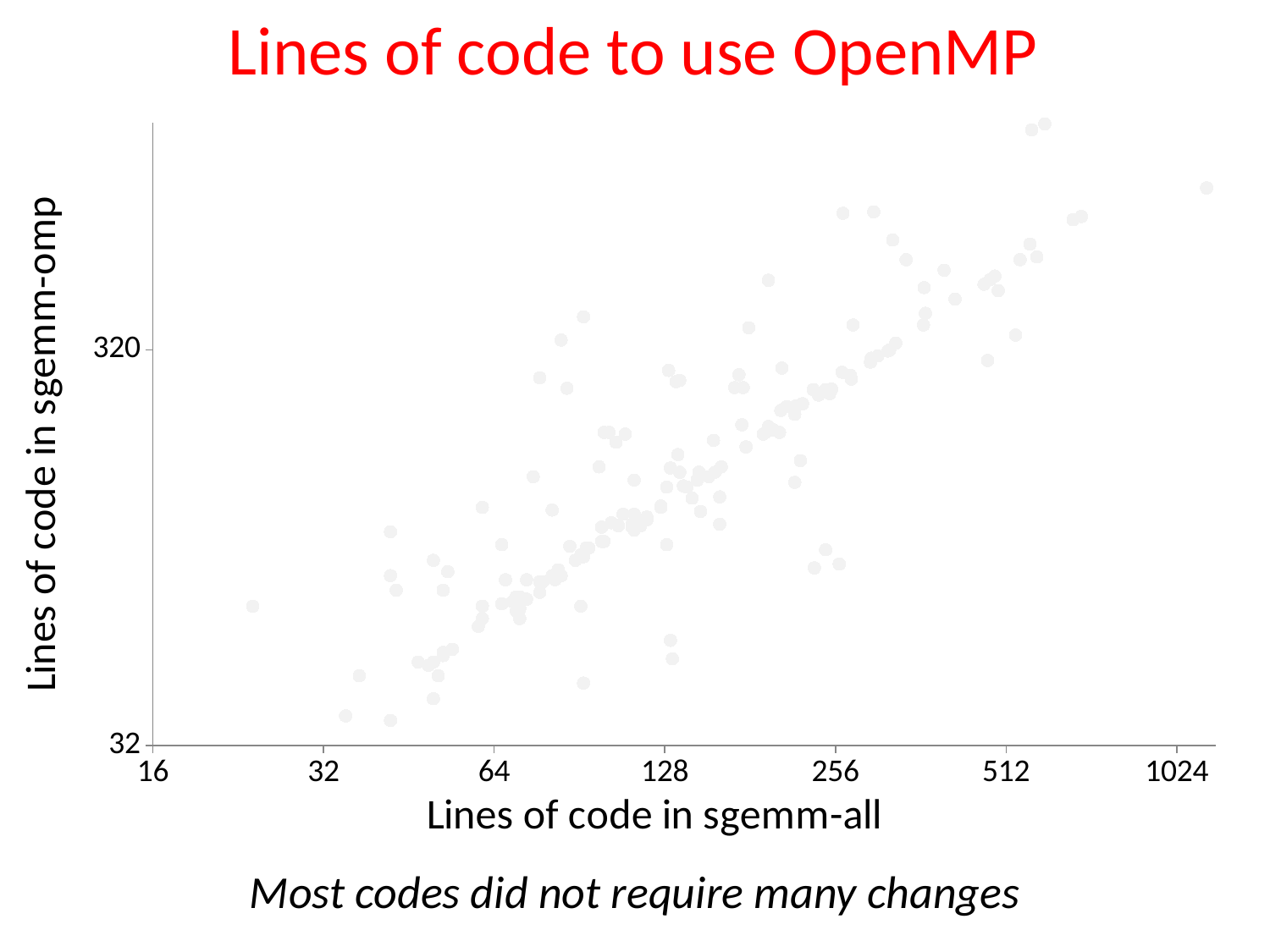
What kind of chart is shown on the slide? scatter plot What is the label of the x axis? Lines of code in sgemm-all What is the title of the chart? Lines of code to use OpenMP As lines of code in sgemm-all increase along the x axis, do the lines of code in sgemm-omp generally rise or fall? rise